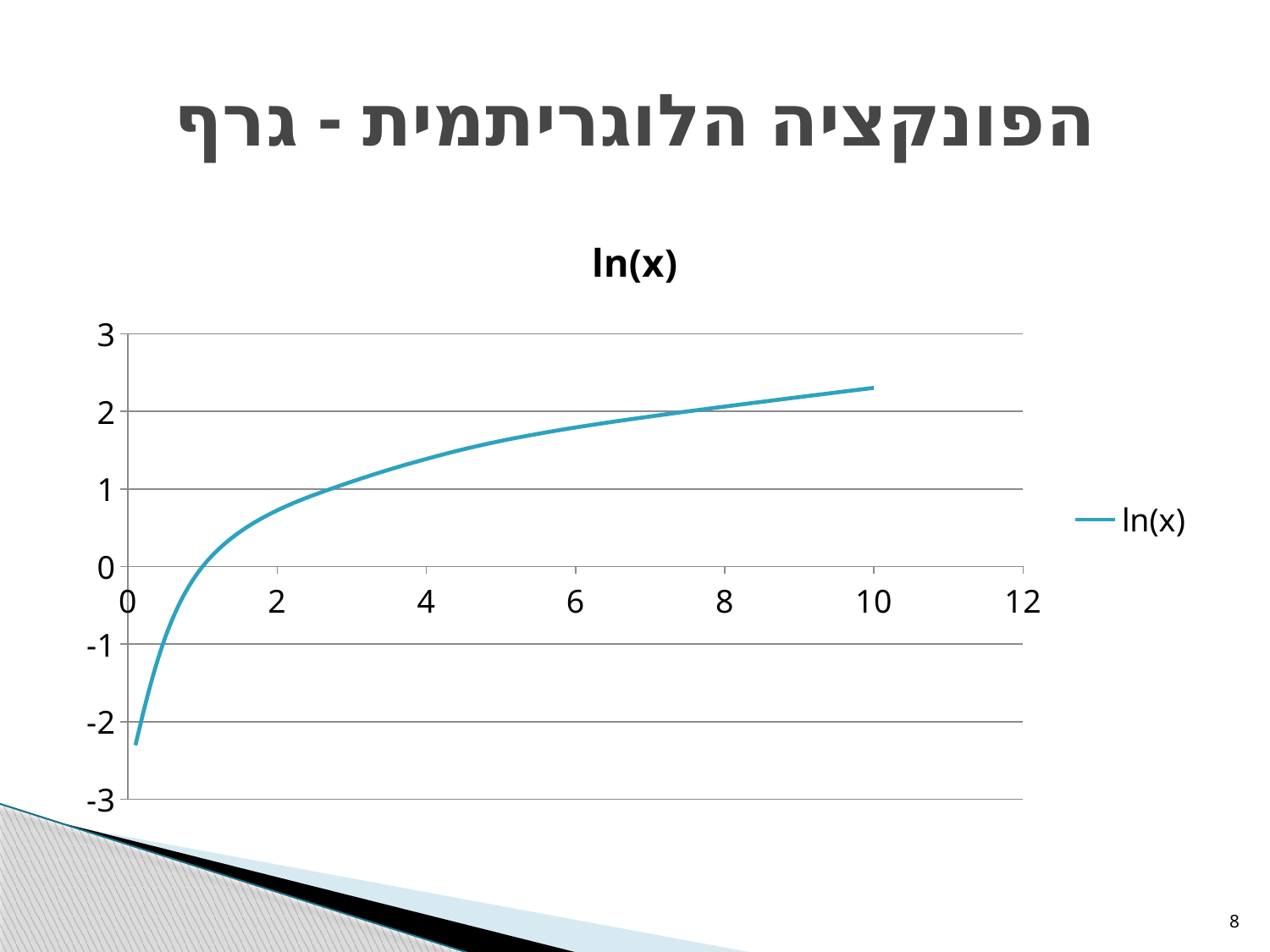
What is the name of the series shown in the legend? ln(x) How many series does the legend list? 1 Is the value of ln(x) at x = 4 greater or less than 1? greater What is the title of the chart? ln(x) Is the value of ln(x) at x = 10 greater or less than 2? greater Is the value of ln(x) at x = 10 greater or less than 3? less What kind of chart is shown on the slide? line chart What is the highest value labelled on the x axis? 12 Which is larger, the value of ln(x) at x = 10 or at x = 2? x = 10 Do the values of ln(x) rise or fall as x increases along the x axis? rise